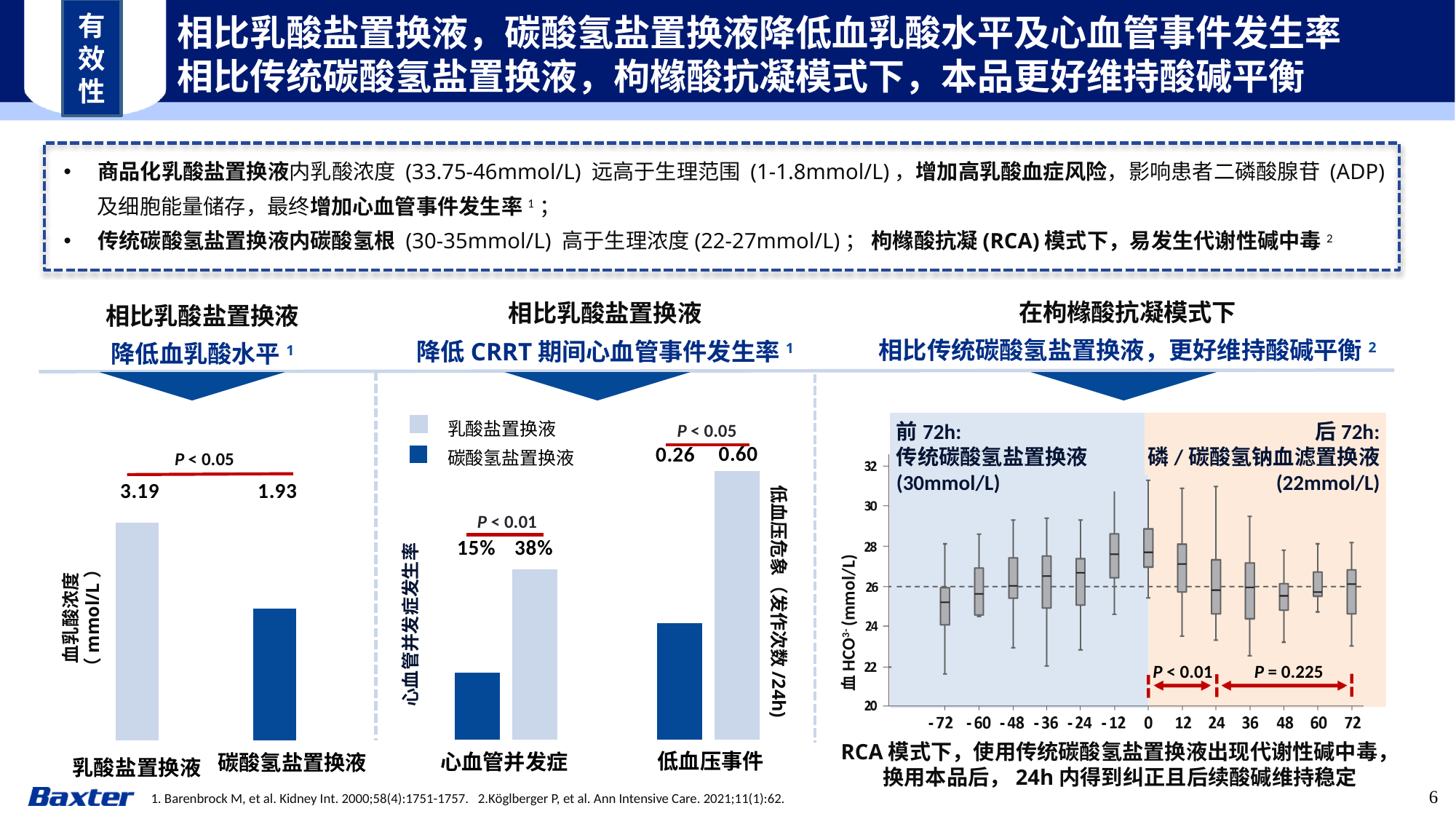
In the middle bar chart, what is the 心血管并发症 rate for 碳酸氢盐置换液? 15% In the middle bar chart, what is the 心血管并发症 rate for 乳酸盐置换液? 38% In the middle bar chart, what is the 低血压事件 value for 乳酸盐置换液? 0.60 In the left bar chart (血乳酸浓度), what is the difference between the 乳酸盐置换液 and 碳酸氢盐置换液 values? 1.26 In the left bar chart (血乳酸浓度), what is the value for 碳酸氢盐置换液? 1.93 In the middle bar chart, how many series does the legend list? 2 In the left bar chart (血乳酸浓度), what is the value for 乳酸盐置换液? 3.19 In the middle bar chart, what is the 低血压事件 value for 碳酸氢盐置换液? 0.26 In the left bar chart (血乳酸浓度), which category has the lower value? 碳酸氢盐置换液 In the middle bar chart, which solution has the higher 低血压事件 value, 乳酸盐置换液 or 碳酸氢盐置换液? 乳酸盐置换液 In the right chart (血HCO3-), how many time points are shown on the x axis? 13